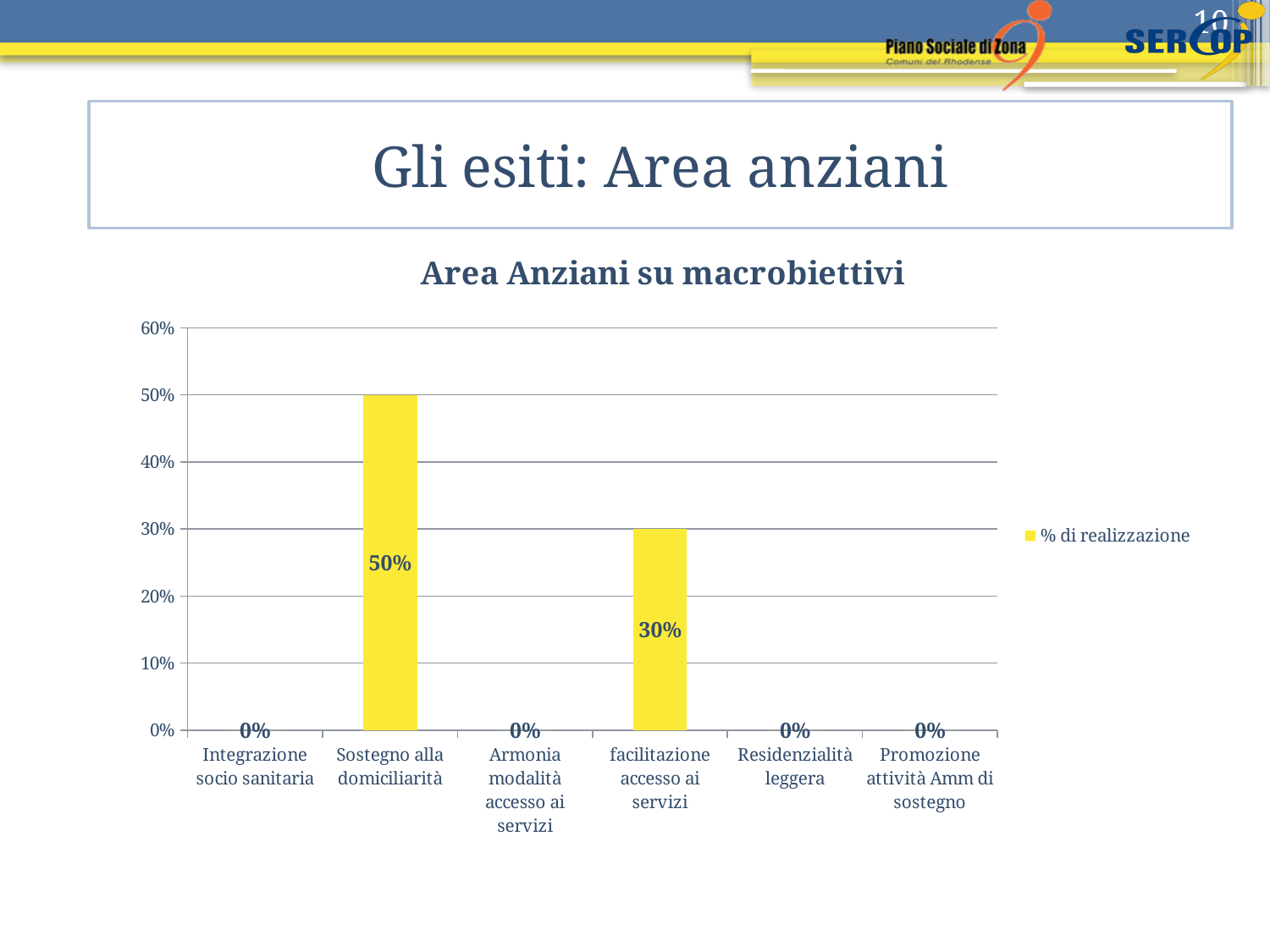
What is the value for facilitazione accesso ai servizi? 30% What is the name of the series in the legend? % di realizzazione Is the value for Sostegno alla domiciliarità greater or less than 40%? greater Which category has the highest value? Sostegno alla domiciliarità What is the difference between the values for Sostegno alla domiciliarità and facilitazione accesso ai servizi? 20% Which is larger, the value for Sostegno alla domiciliarità or the value for facilitazione accesso ai servizi? Sostegno alla domiciliarità How many categories are shown on the x axis? 6 What is the title of the chart? Area Anziani su macrobiettivi What is the value for Sostegno alla domiciliarità? 50% What is the value for Residenzialità leggera? 0% What kind of chart is shown? bar chart How many series does the legend list? 1